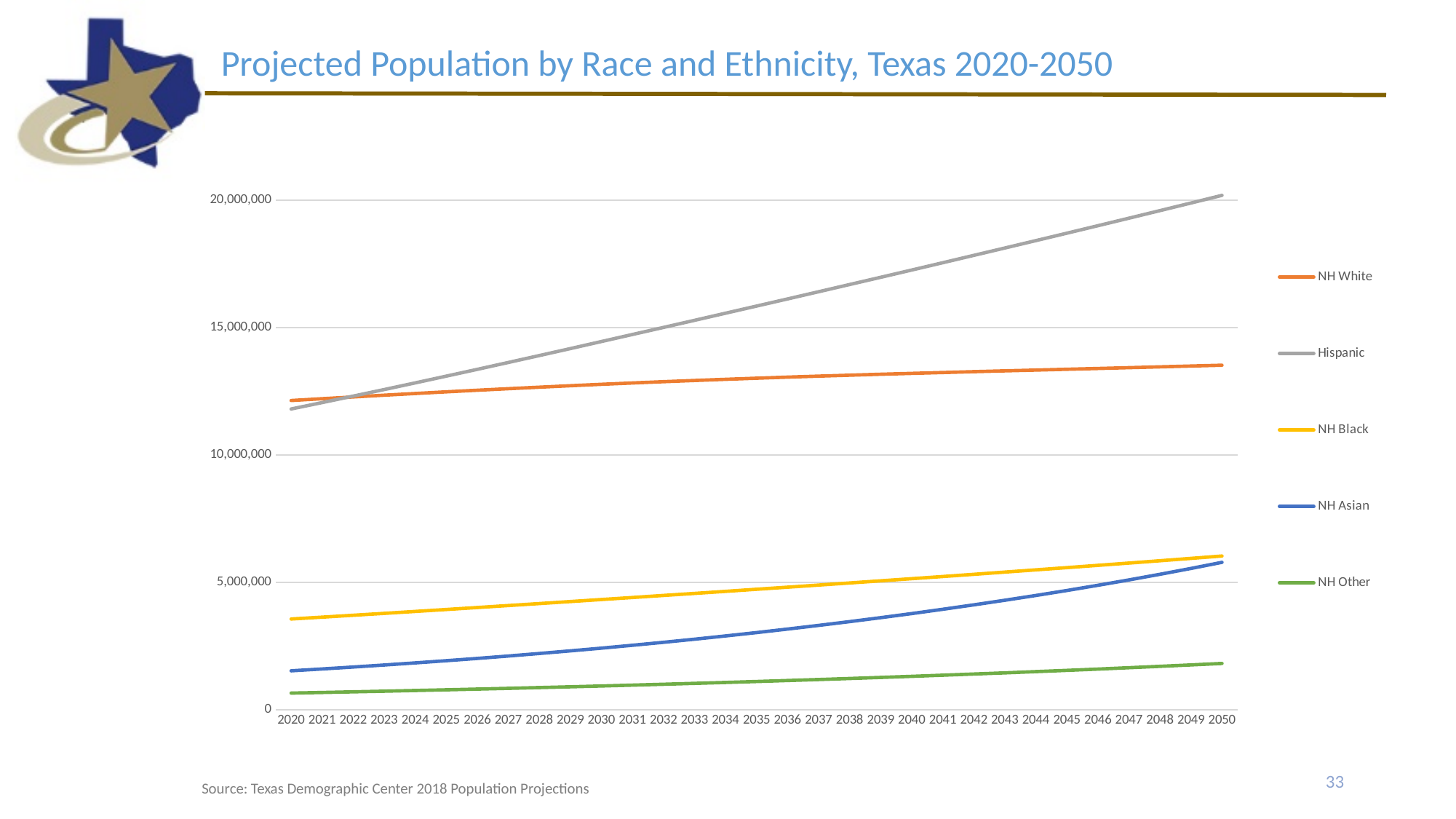
Does the Hispanic population rise or fall from 2020 to 2050? Rise What kind of chart is shown on the slide? Line chart In 2020, which is larger: NH Black or NH Asian? NH Black Is the value for NH Other in 2050 greater or less than 5,000,000? less Is the value for NH Asian in 2050 greater or less than 5,000,000? greater Which group has the lowest projected population in 2050? NH Other Is the value for Hispanic in 2050 greater or less than 15,000,000? greater Which group has the highest projected population in 2050? Hispanic How many years are shown along the x axis? 31 What is the title of the chart? Projected Population by Race and Ethnicity, Texas 2020-2050 How many series does the legend list? 5